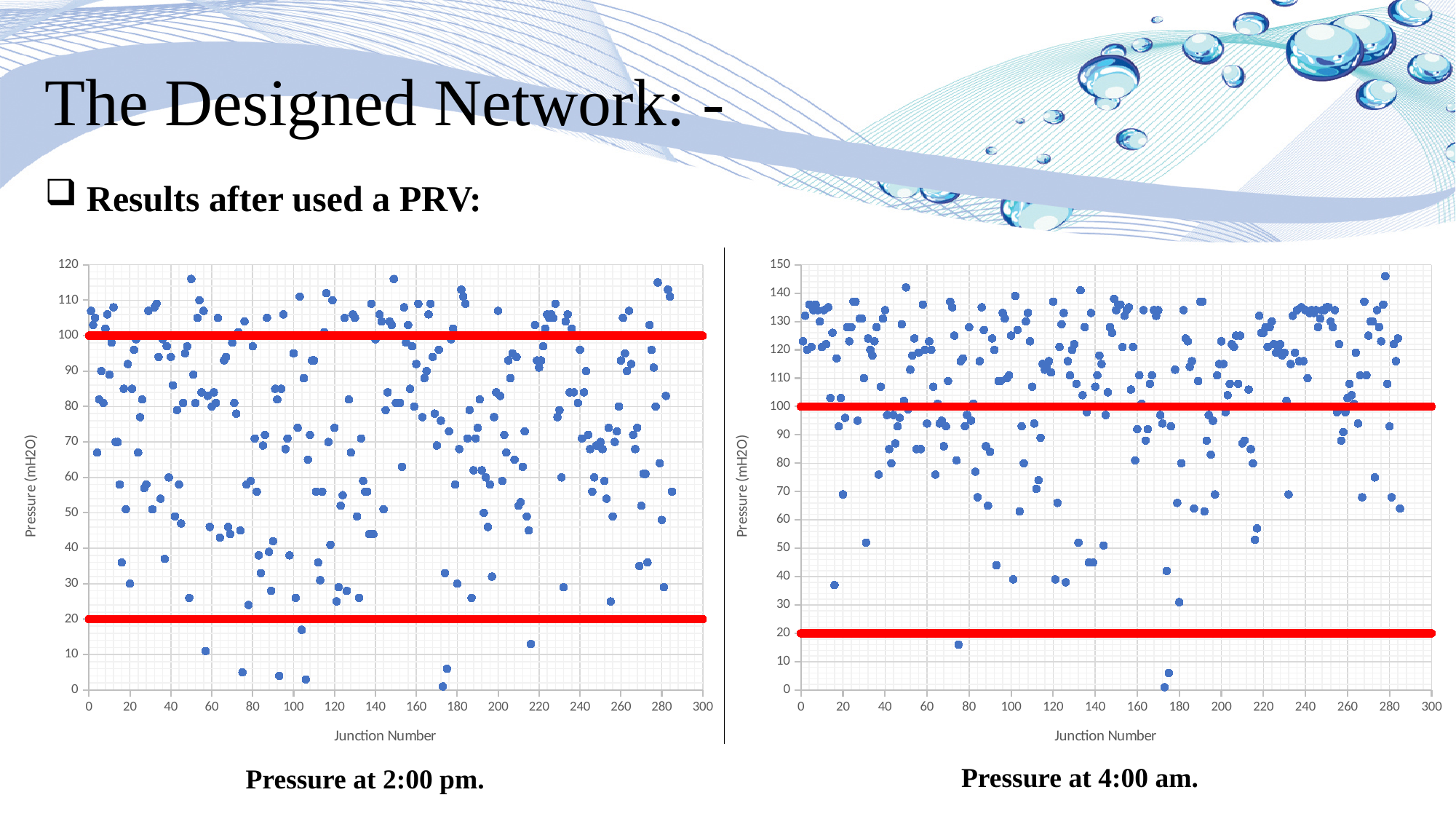
On the 'Pressure at 2:00 pm.' chart, at what pressure value is the lower red horizontal line drawn? 20 On the 'Pressure at 2:00 pm.' chart, what is the maximum junction number shown on the x axis? 300 What kind of chart is the 'Pressure at 4:00 am.' chart on the right? scatter chart On the 'Pressure at 2:00 pm.' chart, what is the highest value shown on the y axis? 120 How many charts are shown on the slide? 2 On the 'Pressure at 2:00 pm.' chart, what is the label of the y axis? Pressure (mH2O) On the 'Pressure at 4:00 am.' chart, at what pressure value is the upper red horizontal line drawn? 100 On the 'Pressure at 4:00 am.' chart, what is the highest value shown on the y axis? 150 On the 'Pressure at 4:00 am.' chart, what is the label of the x axis? Junction Number On the 'Pressure at 2:00 pm.' chart, at what pressure value is the upper red horizontal line drawn? 100 What kind of chart is the 'Pressure at 2:00 pm.' chart on the left? scatter chart On the 'Pressure at 4:00 am.' chart, at what pressure value is the lower red horizontal line drawn? 20